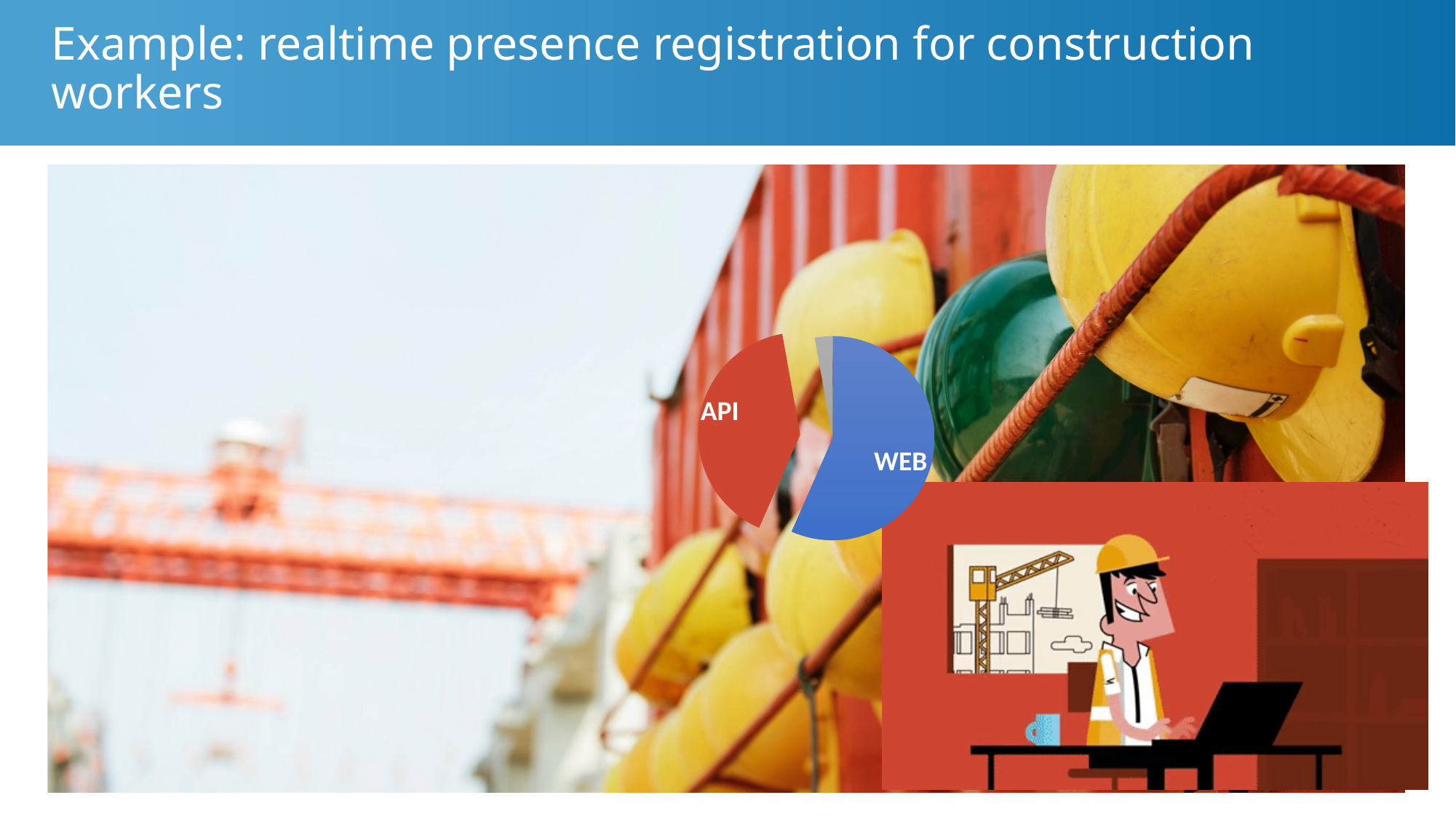
Which labelled slice takes the largest share of the pie chart? WEB What kind of chart is shown on the slide? pie chart Which labelled slice of the pie chart is larger, API or WEB? WEB How many slices does the pie chart have? 3 What colour is the API slice of the pie chart? red Is the WEB slice greater or less than half of the pie chart? greater What colour is the WEB slice of the pie chart? blue Is the API slice greater or less than half of the pie chart? less